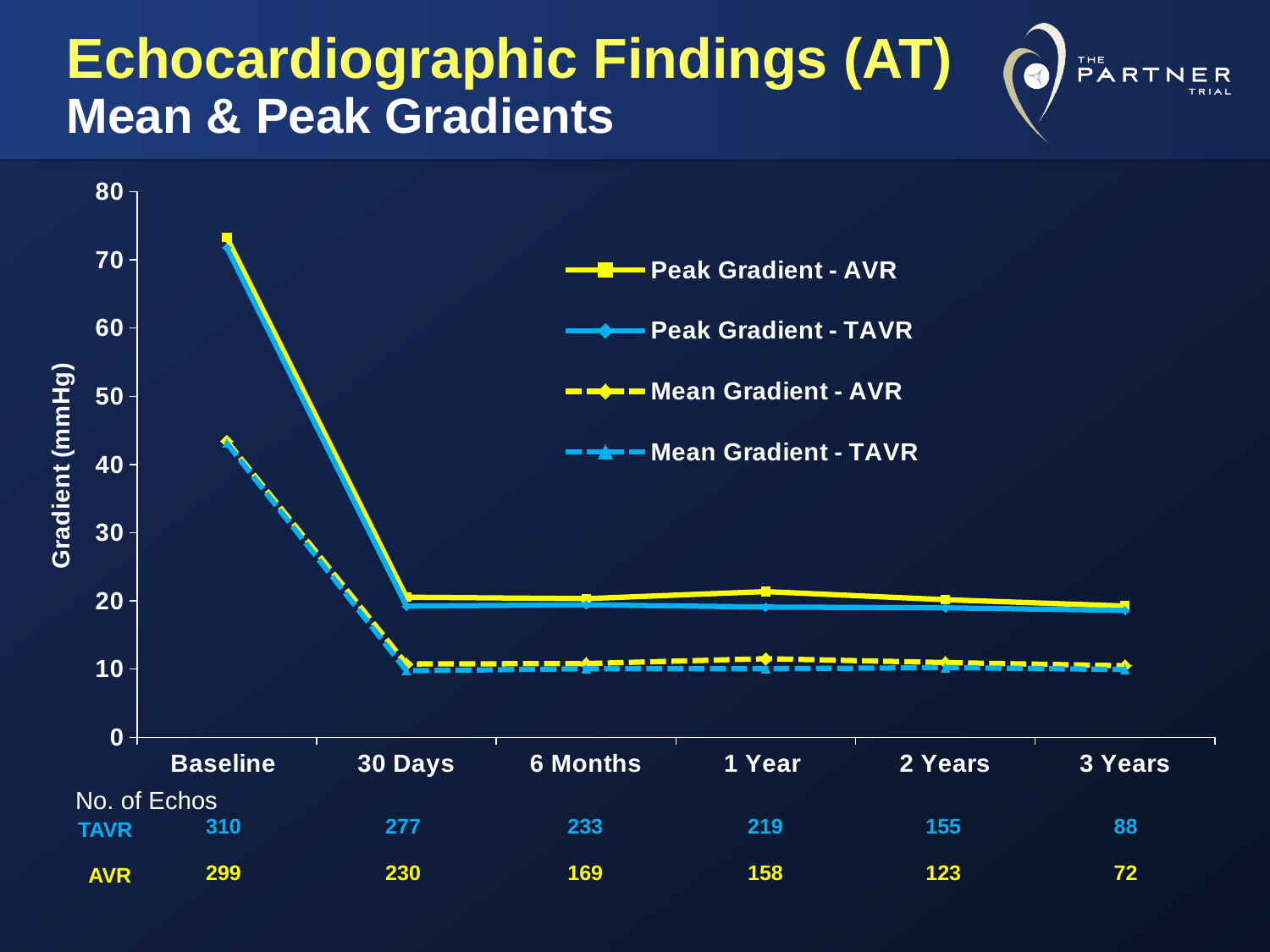
Does the Peak Gradient - AVR line rise or fall from Baseline to 30 Days? fall Is the value for Peak Gradient - AVR at Baseline greater or less than 70? greater Is the value for Mean Gradient - AVR at Baseline greater or less than 40? greater What is the title of the y axis? Gradient (mmHg) Is the value for Mean Gradient - TAVR at 3 Years greater or less than 20? less At which time point is Peak Gradient - AVR highest? Baseline Which legend entry is drawn with a dashed line and triangle markers? Mean Gradient - TAVR How many series does the legend list? 4 What kind of chart is shown on the slide? line chart How many time points are shown along the x axis? 6 At Baseline, which is larger: Peak Gradient - AVR or Mean Gradient - AVR? Peak Gradient - AVR